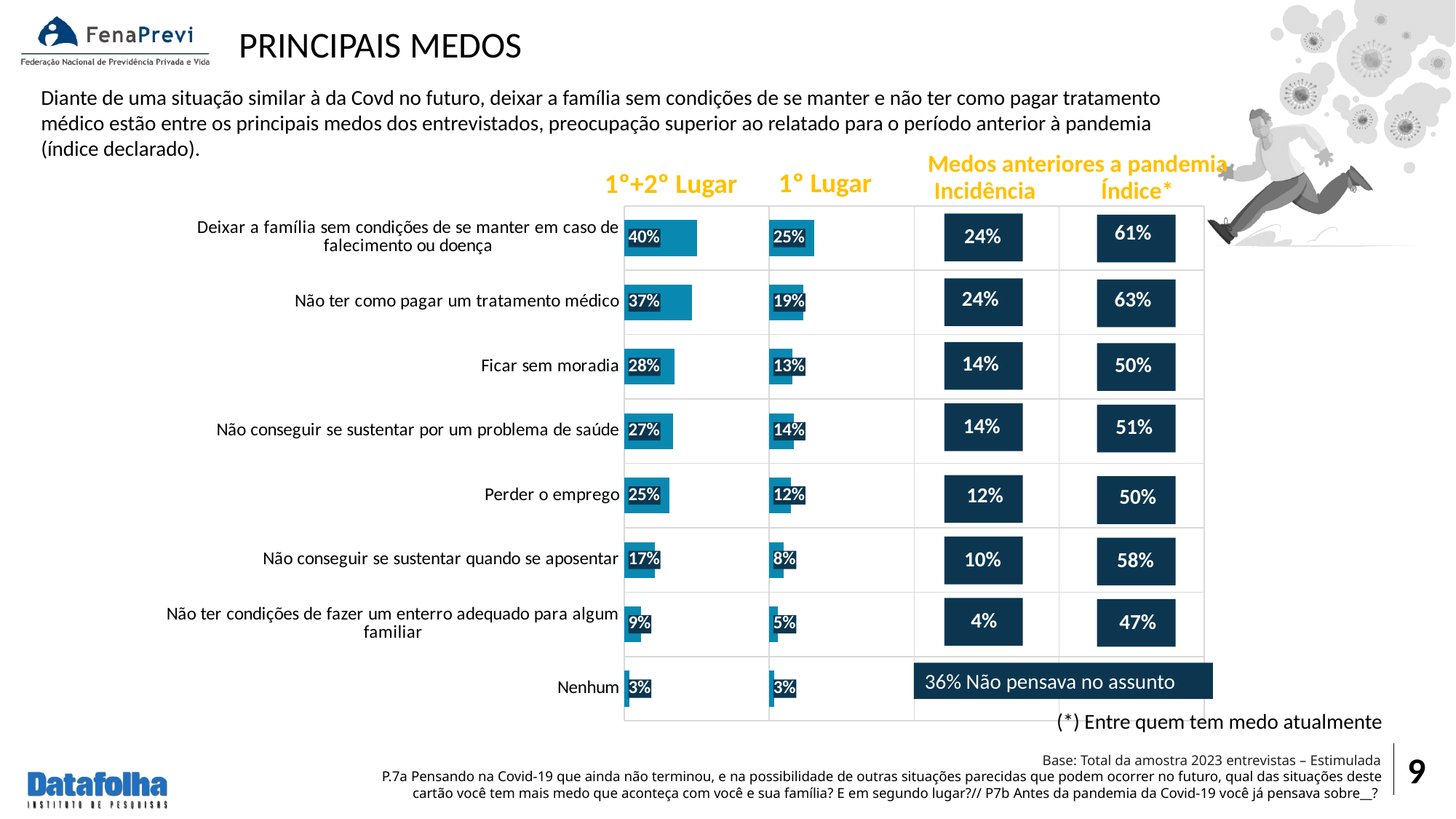
In the "1º+2º Lugar" series, what is the value for "Não ter como pagar um tratamento médico"? 37% Which category has the lowest value in the "1º+2º Lugar" series? Nenhum How many bar series does the chart show ("1º+2º Lugar" and "1º Lugar")? 2 In the "Índice*" column under "Medos anteriores a pandemia", what is the value for "Não conseguir se sustentar quando se aposentar"? 58% What type of chart is used to show the "1º+2º Lugar" and "1º Lugar" values? Bar chart What is the difference between the "1º+2º Lugar" and "1º Lugar" values for "Perder o emprego"? 13% How many categories are listed in the bar chart? 8 In the "1º Lugar" series, what is the value for "Ficar sem moradia"? 13% In the "Incidência" column, what is the value for "Não ter condições de fazer um enterro adequado para algum familiar"? 4% Which category has the highest value in the "1º+2º Lugar" series? Deixar a família sem condições de se manter em caso de falecimento ou doença What is the title of the slide containing the chart? PRINCIPAIS MEDOS In the "1º Lugar" series, which is larger: "Não conseguir se sustentar por um problema de saúde" or "Não conseguir se sustentar quando se aposentar"? Não conseguir se sustentar por um problema de saúde